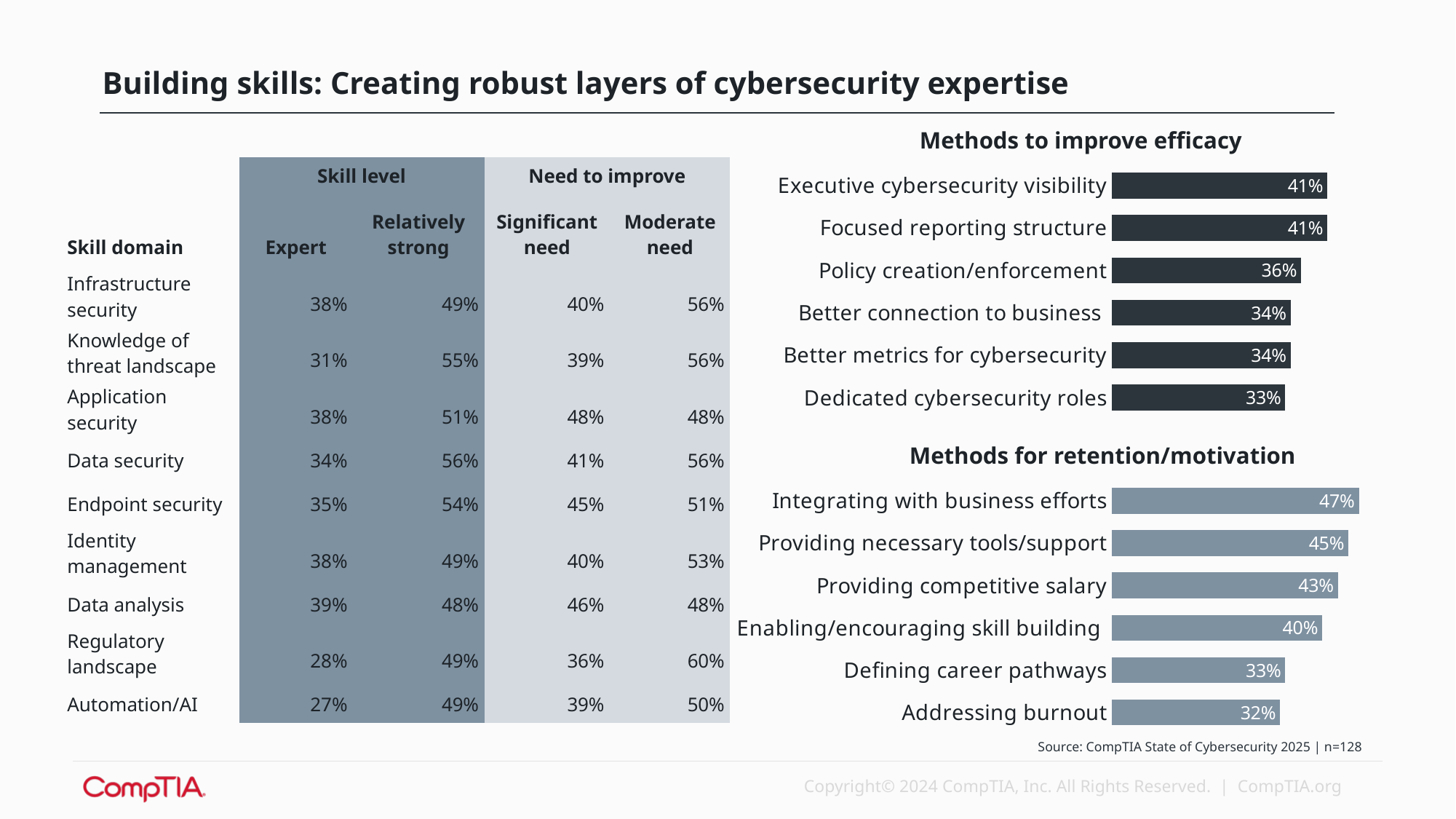
In the 'Methods for retention/motivation' chart, which category has the lowest value? Addressing burnout In the 'Methods to improve efficacy' chart, what is the value for Dedicated cybersecurity roles? 33% In the 'Methods to improve efficacy' chart, what is the difference between Executive cybersecurity visibility and Better connection to business? 7% In the 'Methods for retention/motivation' chart, which category has the highest value? Integrating with business efforts In the 'Methods for retention/motivation' chart, which is larger: Providing necessary tools/support or Enabling/encouraging skill building? Providing necessary tools/support In the 'Methods to improve efficacy' chart, which category has the lowest value? Dedicated cybersecurity roles In the 'Methods to improve efficacy' chart, what is the value for Policy creation/enforcement? 36% In the 'Methods for retention/motivation' chart, what is the value for Providing competitive salary? 43% What type of chart is the 'Methods for retention/motivation' chart? Bar chart How many categories are shown in the 'Methods to improve efficacy' chart? 6 In the 'Methods for retention/motivation' chart, what is the difference between Integrating with business efforts and Defining career pathways? 14% How many categories are shown in the 'Methods for retention/motivation' chart? 6